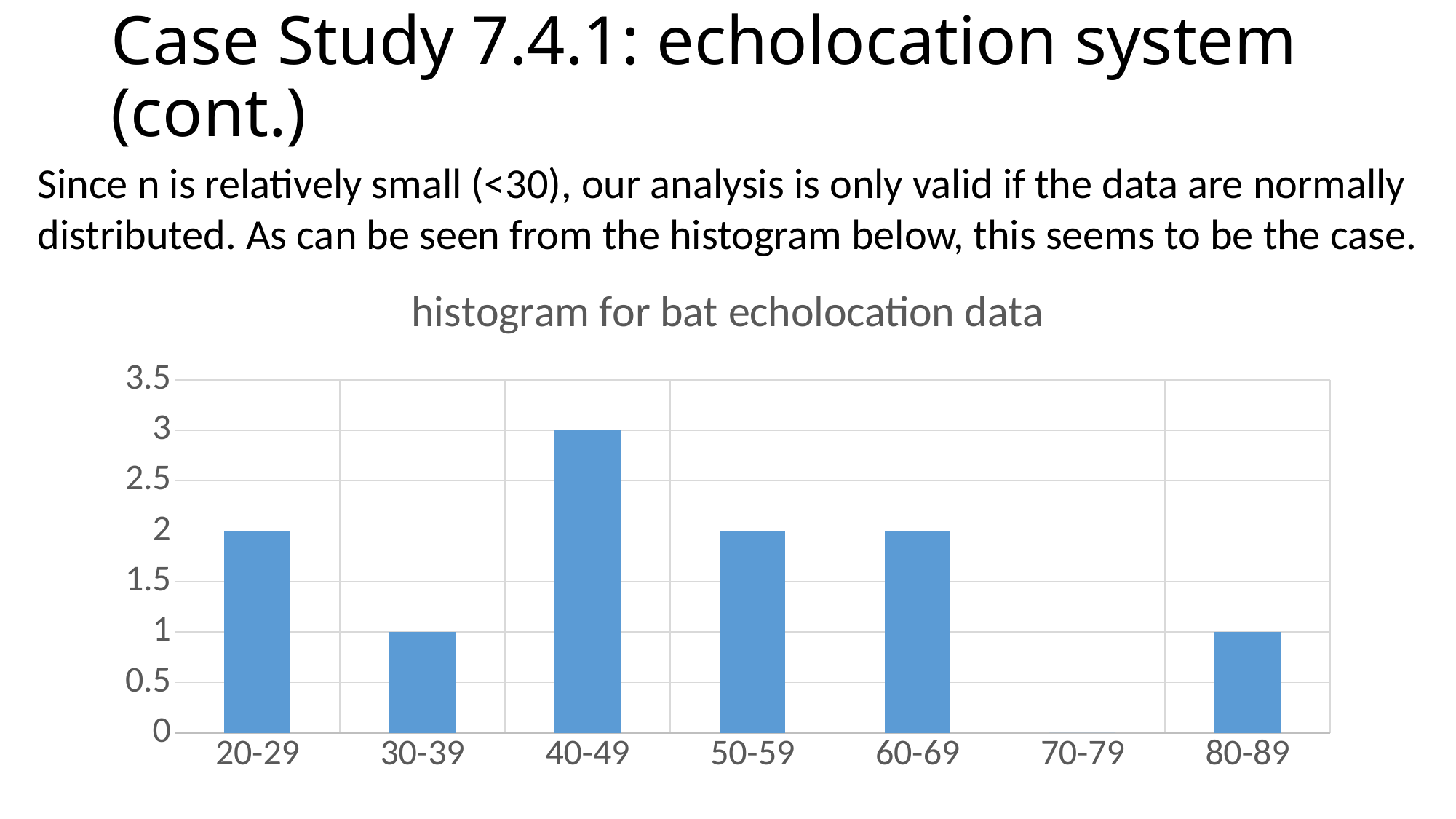
What is the value for the 30-39 category? 1 How many categories are shown on the x axis? 7 What kind of chart is shown on the slide? bar chart What is the value for the 40-49 category? 3 What is the title of the chart? histogram for bat echolocation data Is the value for 40-49 greater or less than 2.5? greater What is the value for the 70-79 category? 0 What is the difference between the values for 40-49 and 80-89? 2 Which category has the lowest value? 70-79 What is the highest value shown on the y axis? 3.5 Which category has the highest value? 40-49 Which is larger, the value for 20-29 or the value for 30-39? 20-29